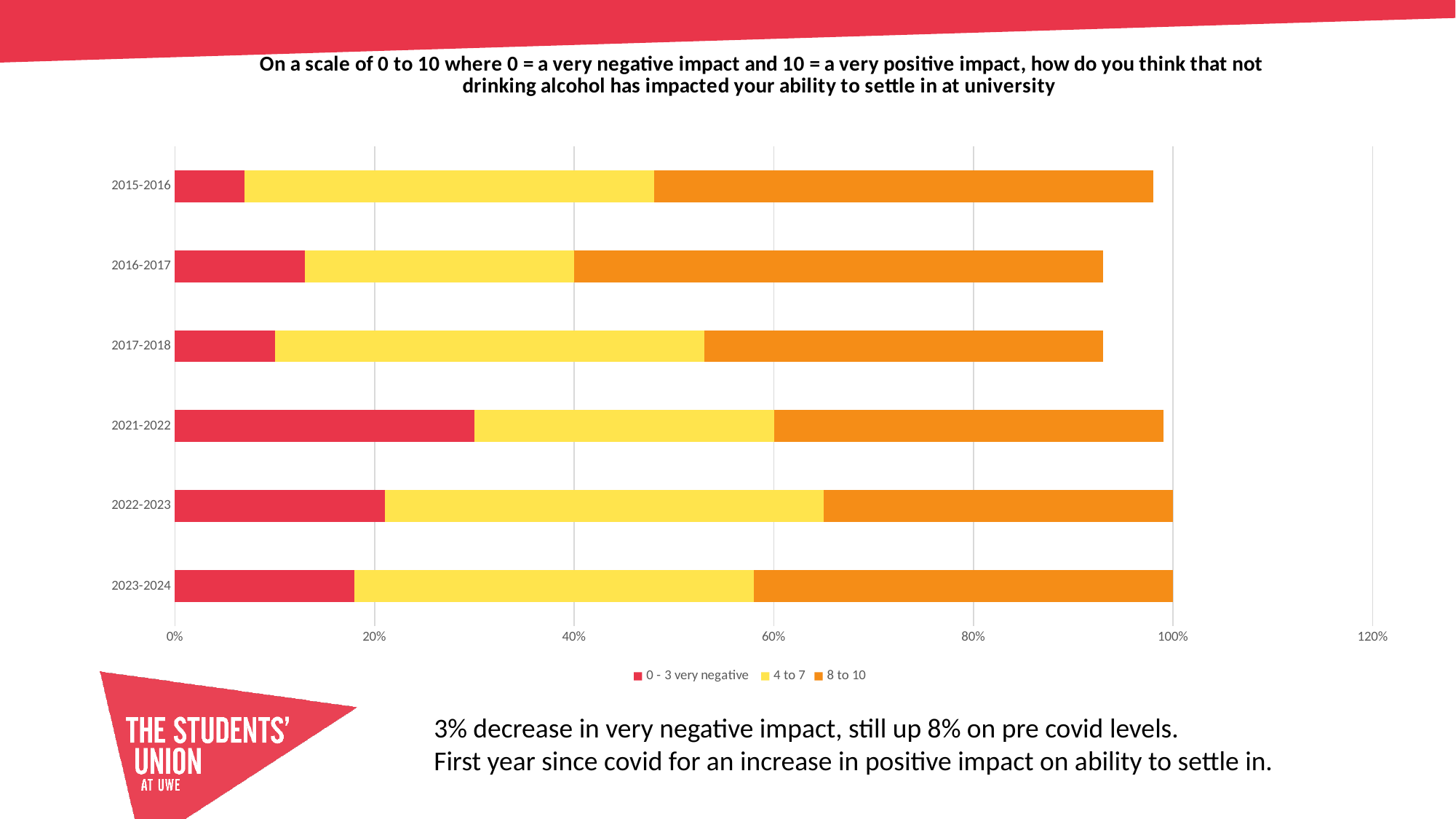
Is the '0 - 3 very negative' value for 2021-2022 greater or less than 20%? greater What kind of chart is shown on the slide? Stacked bar chart What is the total of the stacked bar for 2023-2024? 100% Which year has the largest '0 - 3 very negative' segment? 2021-2022 Is the total length of the stacked bar for 2016-2017 greater or less than 100%? less What colour represents the '8 to 10' series? Orange Is the '0 - 3 very negative' value for 2015-2016 greater or less than 20%? less Which has the larger '0 - 3 very negative' segment, 2021-2022 or 2016-2017? 2021-2022 How many series does the legend list? 3 What are the three legend entries on the chart? 0 - 3 very negative, 4 to 7, 8 to 10 How many academic years are shown on the chart? 6